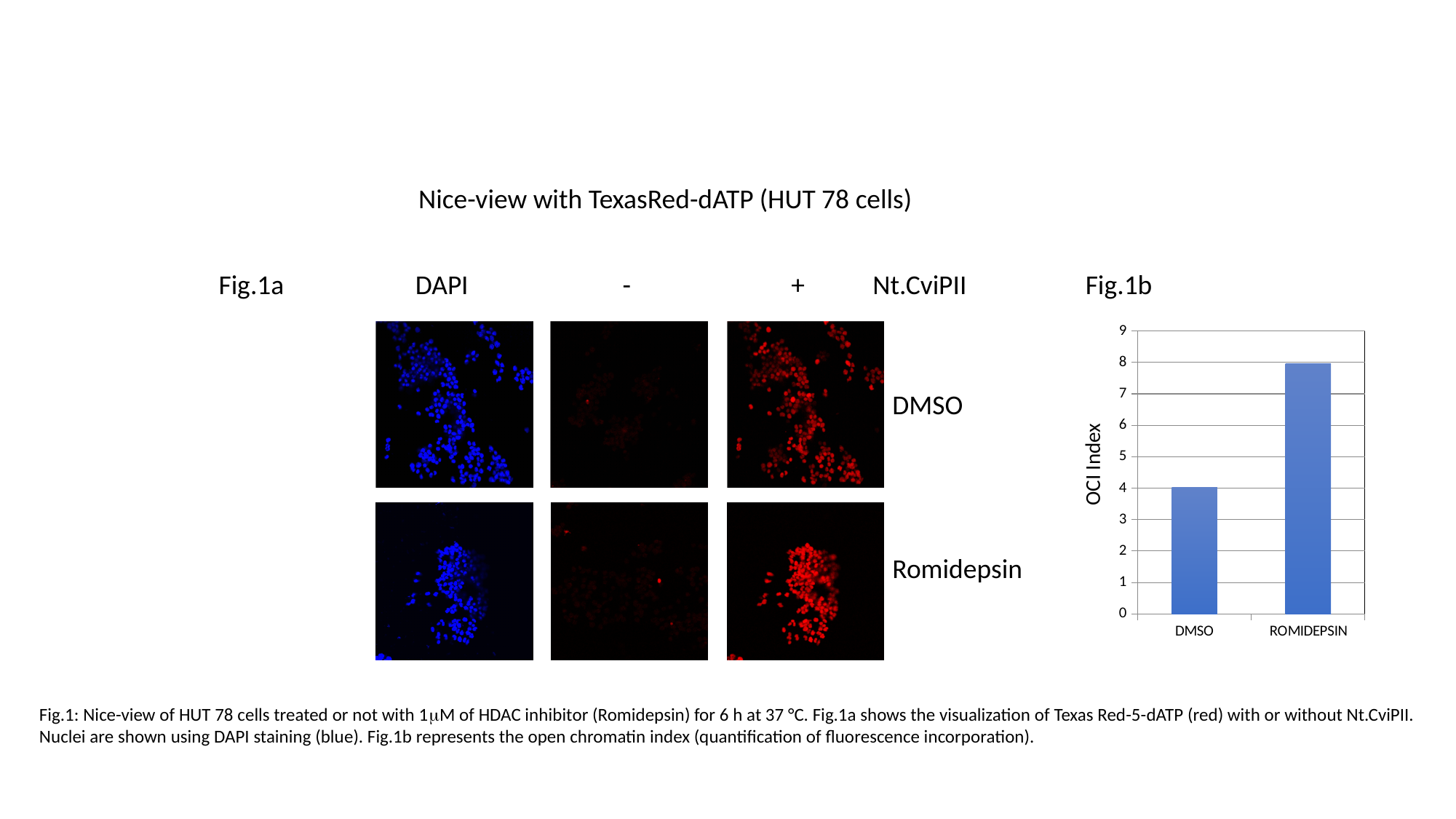
In Fig.1b, what is the label of the y axis? OCI Index In Fig.1b, which category has the lowest OCI Index? DMSO In Fig.1b, which category has the highest OCI Index? ROMIDEPSIN In Fig.1b, is the OCI Index for ROMIDEPSIN greater or less than 9? less In Fig.1b, is the OCI Index for ROMIDEPSIN greater or less than 7? greater In Fig.1b, is the OCI Index for DMSO greater or less than 5? less In Fig.1b, which has a larger OCI Index, DMSO or ROMIDEPSIN? ROMIDEPSIN In Fig.1b, how many categories are shown on the x axis? 2 What kind of chart is Fig.1b? bar chart In Fig.1b, what is the highest value shown on the y axis? 9